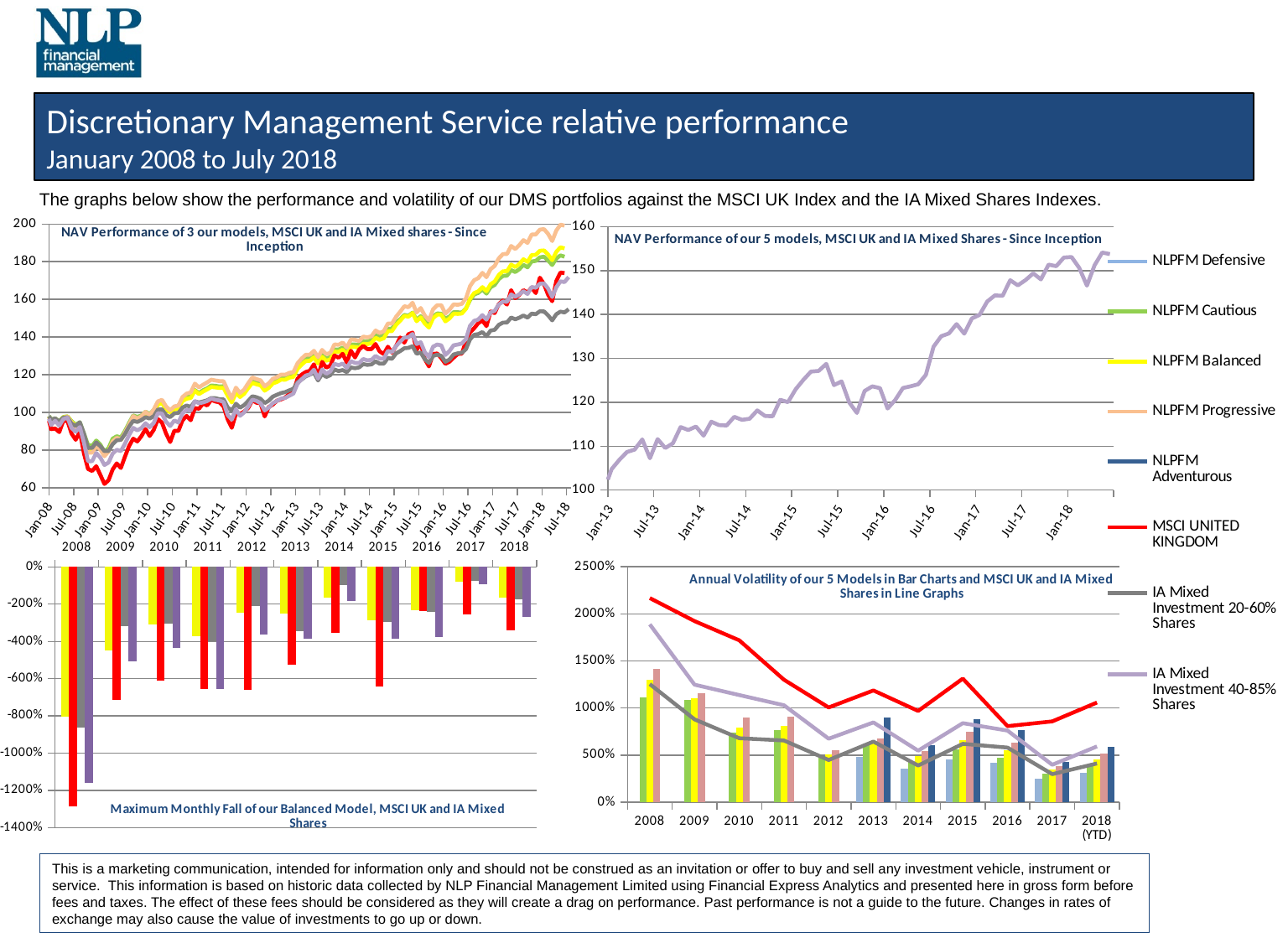
In the bottom-right 'Annual Volatility' chart, in which year does the MSCI UNITED KINGDOM line reach its highest value? 2008 How many entries does the shared legend on the right of the slide list? 8 What type of chart is the bottom-left chart titled 'Maximum Monthly Fall of our Balanced Model, MSCI UK and IA Mixed Shares'? bar chart In the top-right 'NAV Performance of our 5 models' chart, does the plotted line rise or fall overall from Jan-13 to the end of the series? rise In the bottom-left 'Maximum Monthly Fall' chart, which year has the largest fall for MSCI UNITED KINGDOM (red bar)? 2008 In the bottom-right 'Annual Volatility' chart, is the 2008 value of the MSCI UNITED KINGDOM line greater or less than 2000%? greater In the bottom-right 'Annual Volatility' chart, is the 2016 value of the MSCI UNITED KINGDOM line greater or less than 1000%? less In the bottom-left 'Maximum Monthly Fall' chart, is the 2008 value for MSCI UNITED KINGDOM (red bar) greater or less than -1200%? less What type of chart is the top-right chart titled 'NAV Performance of our 5 models, MSCI UK and IA Mixed Shares - Since Inception'? line chart In the top-left 'NAV Performance of 3 our models' chart, which series is highest at Jul-18? NLPFM Progressive In the bottom-left 'Maximum Monthly Fall' chart, how many years are shown on the x axis? 11